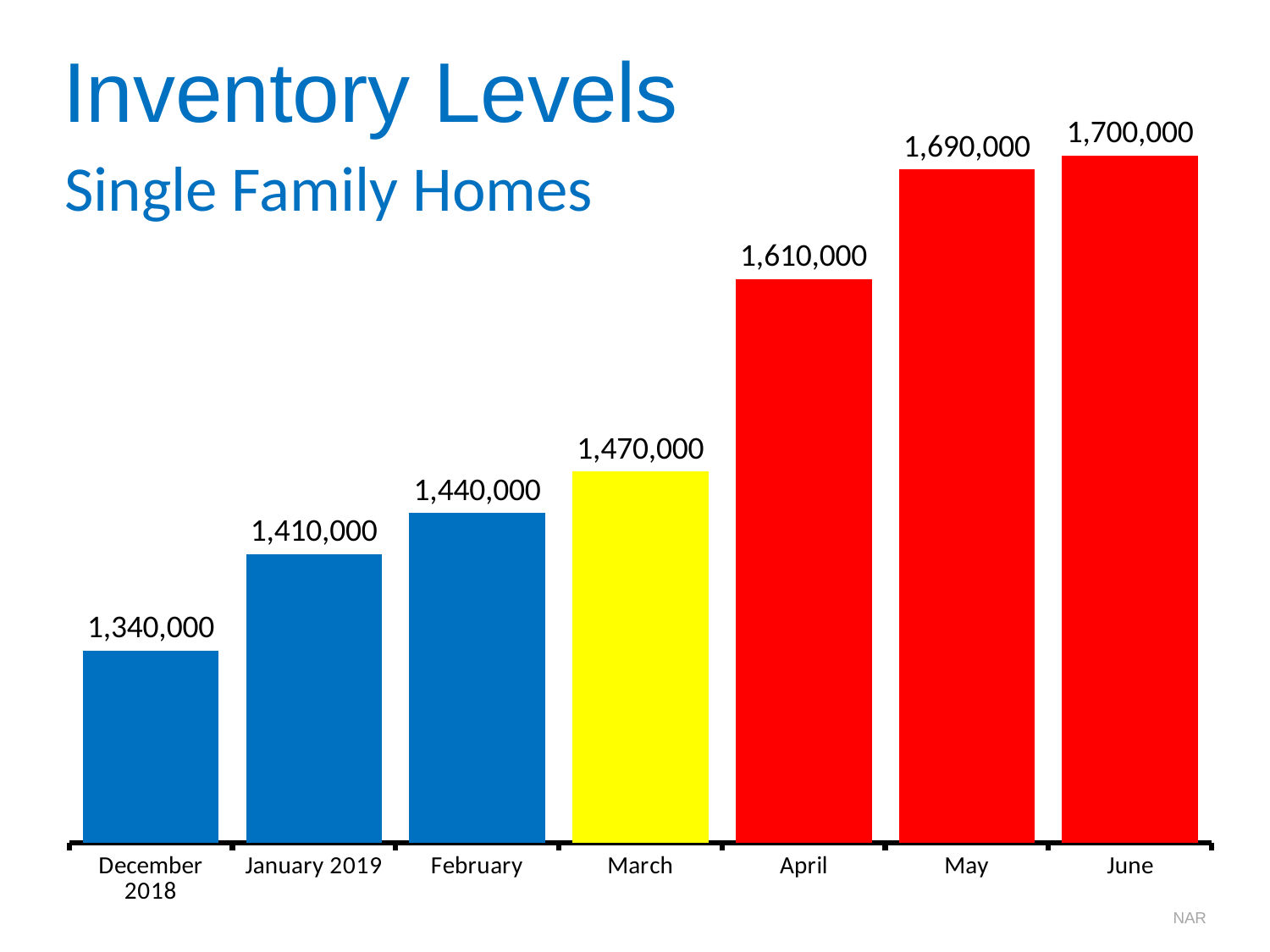
How many months are shown on the chart? 7 What is the inventory level for December 2018? 1,340,000 What is the inventory level for May? 1,690,000 Which month has the lowest inventory level? December 2018 What is the difference between the inventory levels for April and March? 140,000 What is the difference between the inventory levels for June and December 2018? 360,000 Which is larger, the inventory level for February or for January 2019? February What is the inventory level for March? 1,470,000 What colour is the bar for March? Yellow Which month has the highest inventory level? June What kind of chart is shown on the slide? Bar chart Do the inventory levels rise or fall from December 2018 to June? Rise